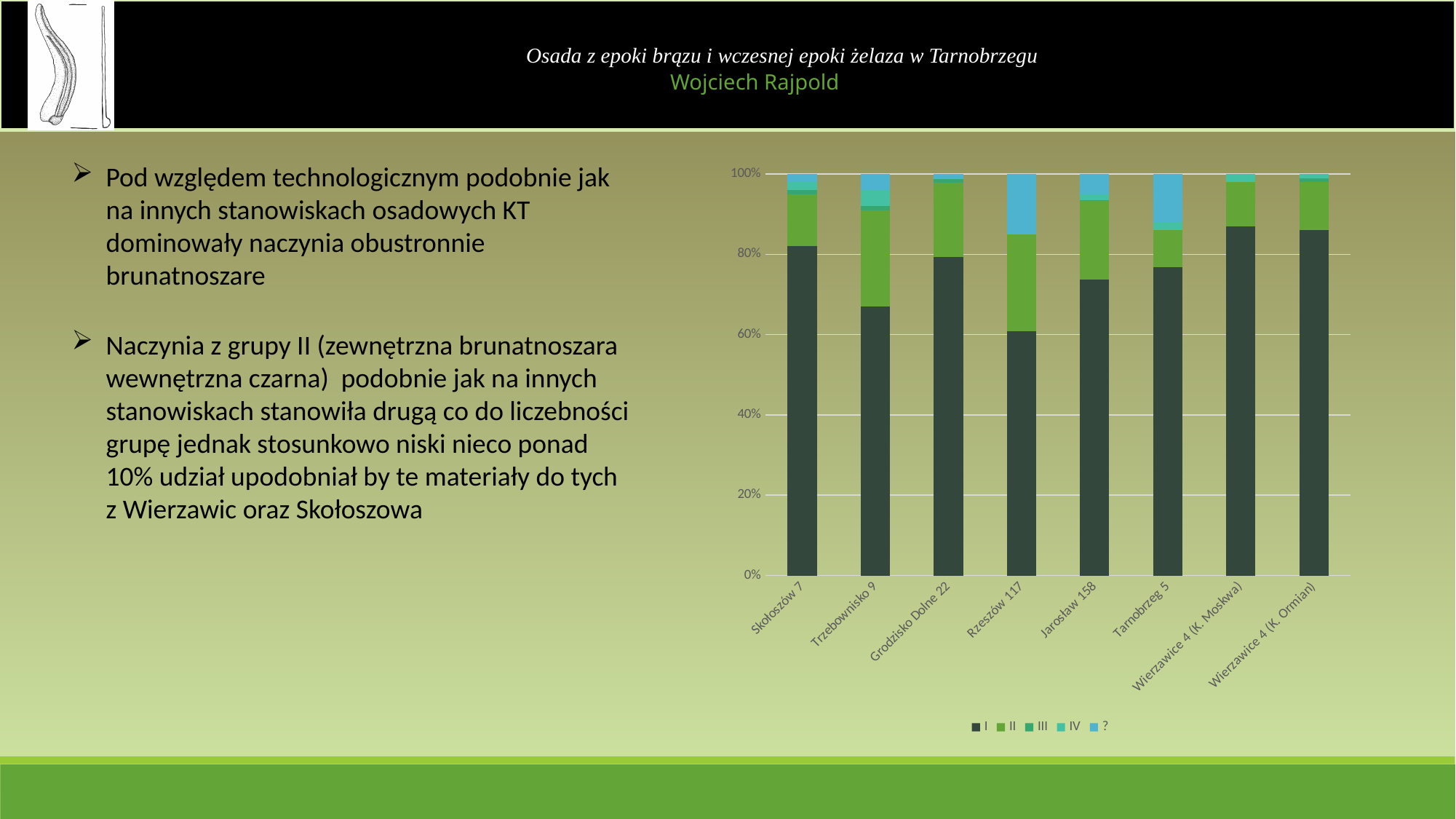
Is the share of series I for Trzebownisko 9 greater or less than 80%? less Is the share of series I for Rzeszów 117 greater or less than 80%? less What kind of chart is shown on the slide? Stacked bar chart Is the share of series I for Jarosław 158 greater or less than 80%? less Which site has the lowest share for series I? Rzeszów 117 How many sites (categories) are shown on the x axis of the chart? 8 How many series does the chart legend list? 5 Which site has a larger share of series I, Skołoszów 7 or Trzebownisko 9? Skołoszów 7 What does each stacked bar in the chart total? 100% What are the series names listed in the chart legend? I, II, III, IV, ?